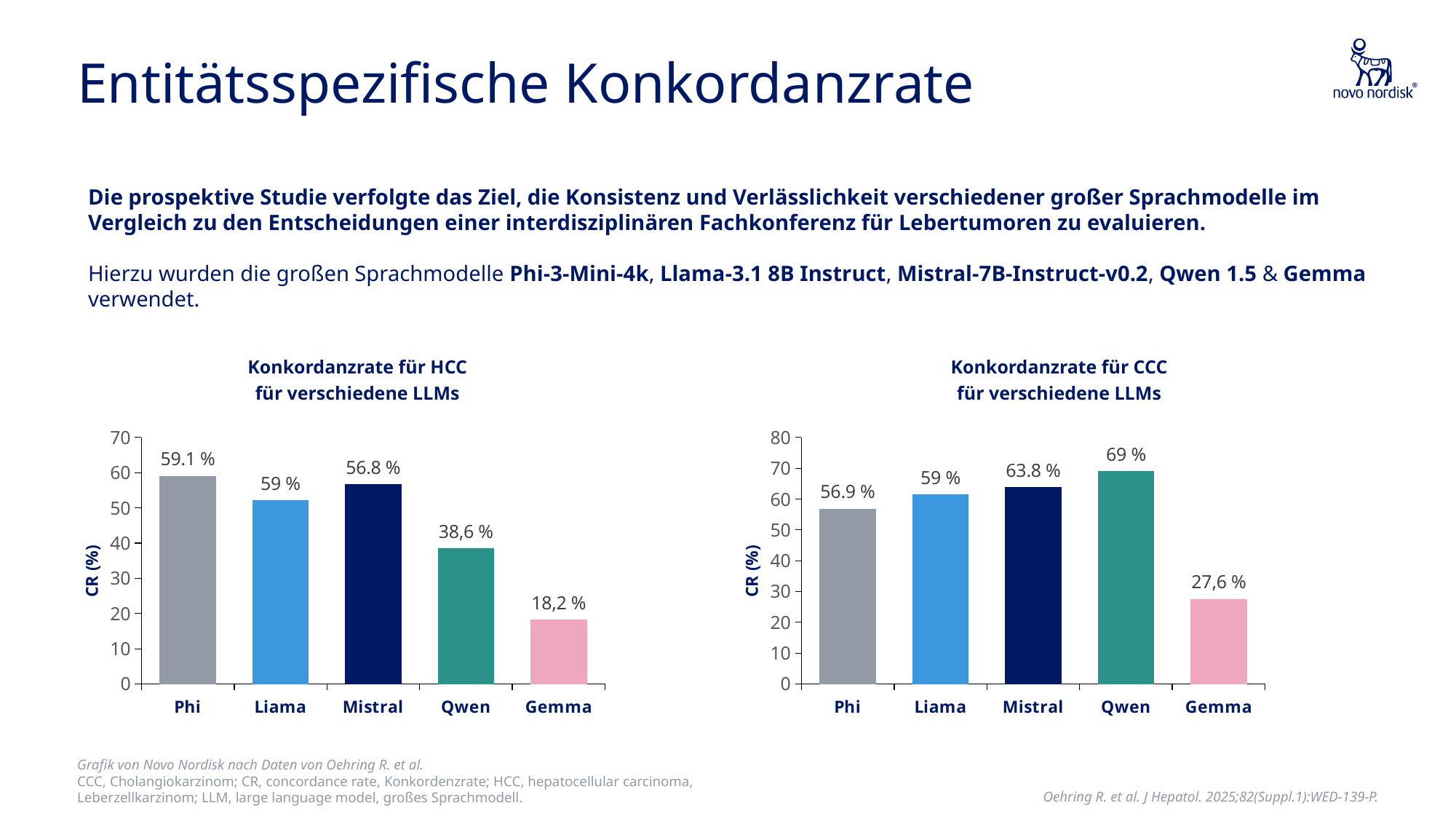
In the chart 'Konkordanzrate für CCC für verschiedene LLMs', what is the value for Mistral? 63.8 % In the chart 'Konkordanzrate für HCC für verschiedene LLMs', what is the value for Gemma? 18,2 % How many models are shown on the x axis of the chart 'Konkordanzrate für HCC für verschiedene LLMs'? 5 In the chart 'Konkordanzrate für HCC für verschiedene LLMs', which is larger, the value for Mistral or the value for Qwen? Mistral In the chart 'Konkordanzrate für HCC für verschiedene LLMs', which model has the lowest concordance rate? Gemma In the chart 'Konkordanzrate für CCC für verschiedene LLMs', which model has the highest concordance rate? Qwen In the chart 'Konkordanzrate für HCC für verschiedene LLMs', what is the value for Phi? 59.1 % In the chart 'Konkordanzrate für CCC für verschiedene LLMs', what is the difference between the values for Qwen and Gemma? 41,4 % In the chart 'Konkordanzrate für CCC für verschiedene LLMs', what is the value for Qwen? 69 % In the chart 'Konkordanzrate für CCC für verschiedene LLMs', which model has the lowest concordance rate? Gemma What kind of chart is 'Konkordanzrate für CCC für verschiedene LLMs'? Bar chart What is the y-axis label of the chart 'Konkordanzrate für HCC für verschiedene LLMs'? CR (%)